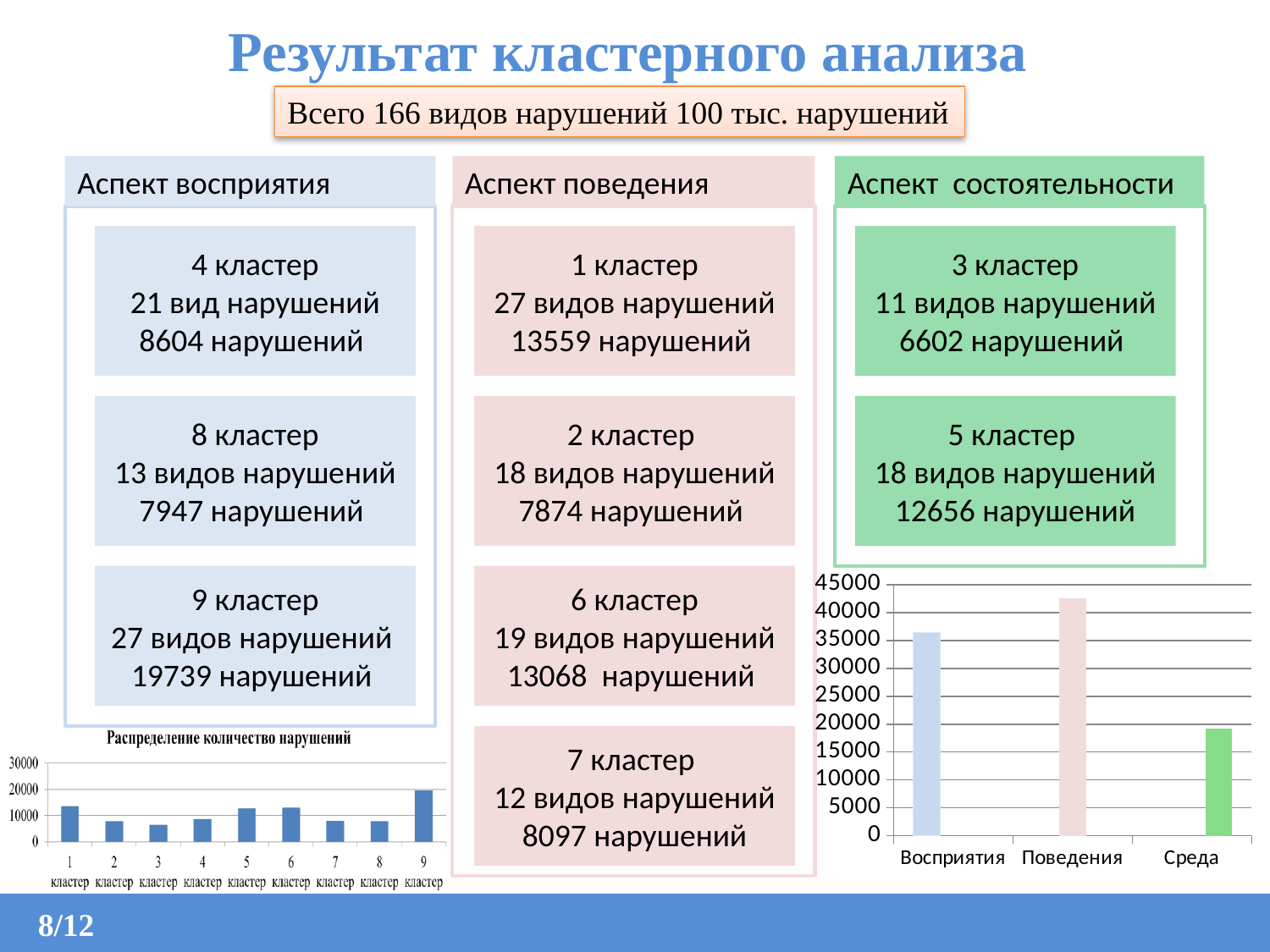
What kind of chart is the chart at the bottom right of the slide? bar chart In the bottom-right chart, which category has the lowest value? Среда In the chart titled "Распределение количество нарушений", is the value for 3 кластер greater or less than 10000? less In the bottom-right chart, is the value for Восприятия greater or less than 30000? greater In the bottom-right chart, is the value for Поведения greater or less than 40000? greater In the bottom-right chart, which category has the highest value? Поведения What kind of chart is the chart titled "Распределение количество нарушений"? bar chart How many clusters are shown in the chart titled "Распределение количество нарушений"? 9 How many categories are shown in the bottom-right chart? 3 In the chart titled "Распределение количество нарушений", which cluster has the highest value? 9 кластер